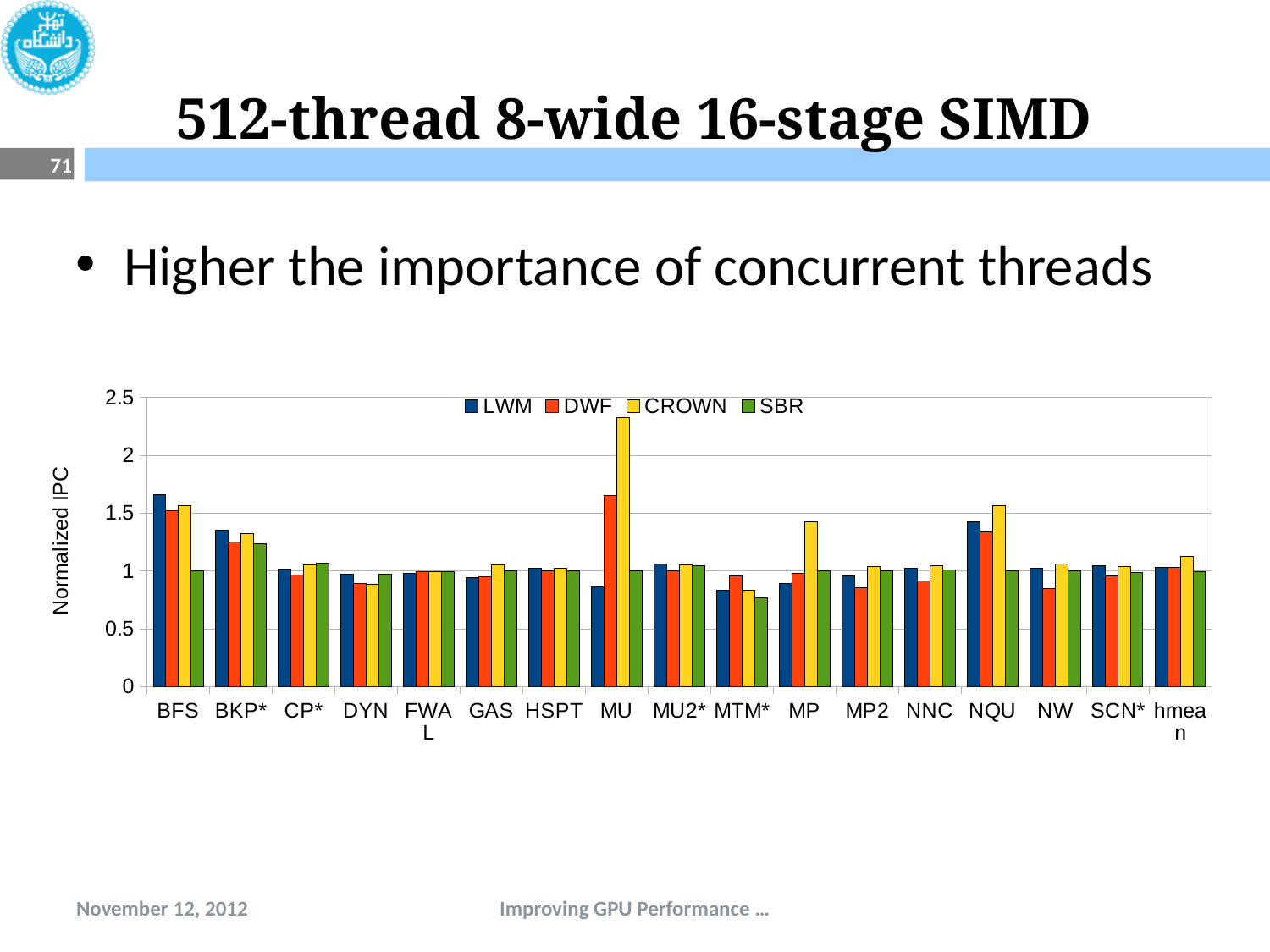
Is the CROWN value for MU greater or less than 2? greater Which series has the highest value for MU? CROWN How many categories are shown along the x axis? 17 Which category has the highest CROWN value? MU How many series does the legend list? 4 For BFS, which is larger: the LWM value or the DWF value? LWM Is the LWM value for BFS greater or less than 1.5? greater What is the label of the y axis? Normalized IPC Which series are listed in the legend? LWM, DWF, CROWN, SBR Is the DWF value for NW greater or less than 1? less What kind of chart is shown on the slide? bar chart